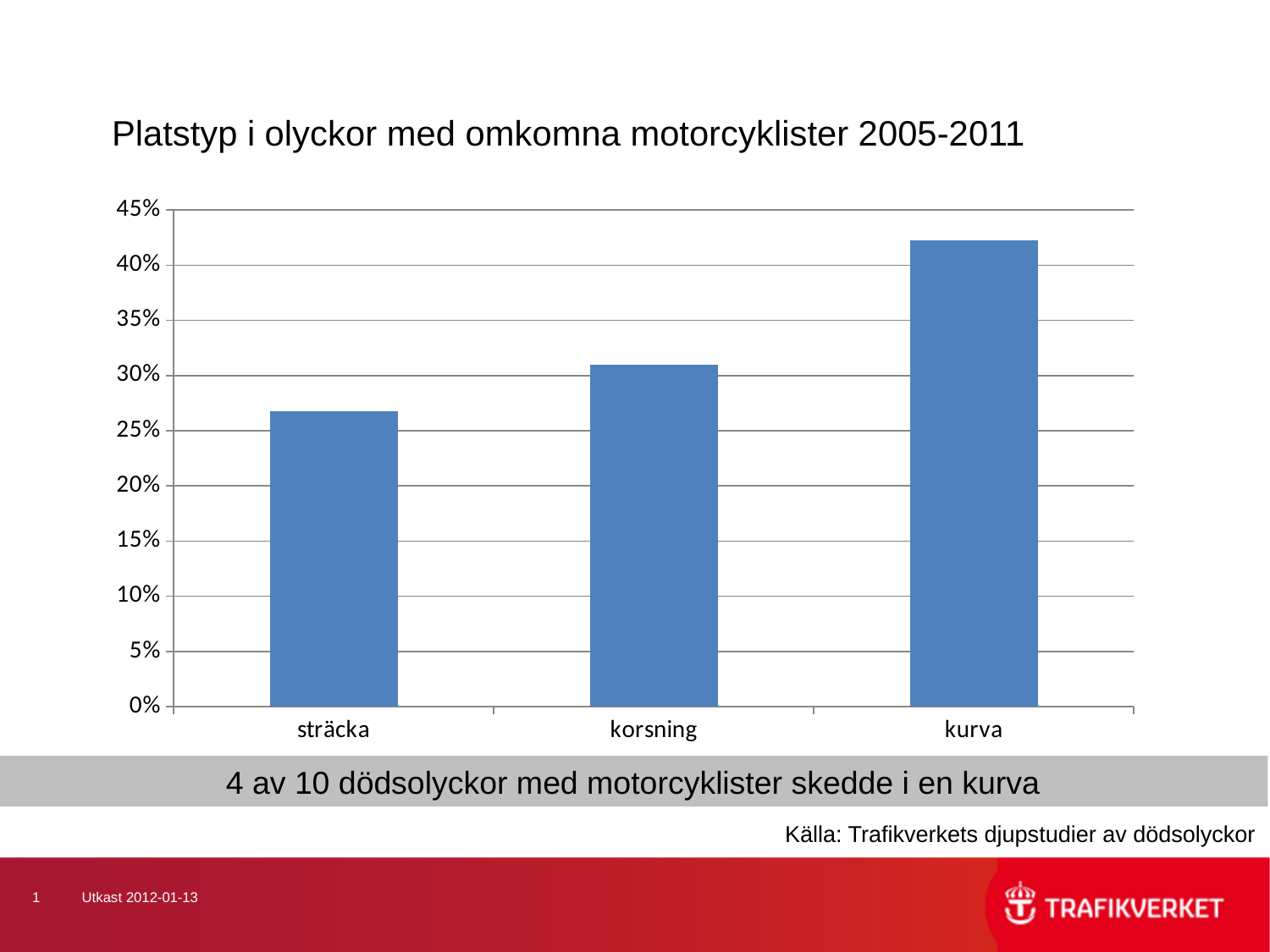
What is the title of the chart? Platstyp i olyckor med omkomna motorcyklister 2005-2011 Is the value for kurva greater or less than 40%? greater Which is larger, the value for korsning or the value for sträcka? korsning Is the value for sträcka greater or less than 30%? less Which is larger, the value for kurva or the value for korsning? kurva How many categories are shown on the x axis of the chart? 3 What is the highest value shown on the y axis of the chart? 45% Is the value for korsning greater or less than 35%? less Which category has the highest value in the chart? kurva What kind of chart is shown on the slide? bar chart Do the values rise or fall from left to right along the x axis? rise Which category has the lowest value in the chart? sträcka